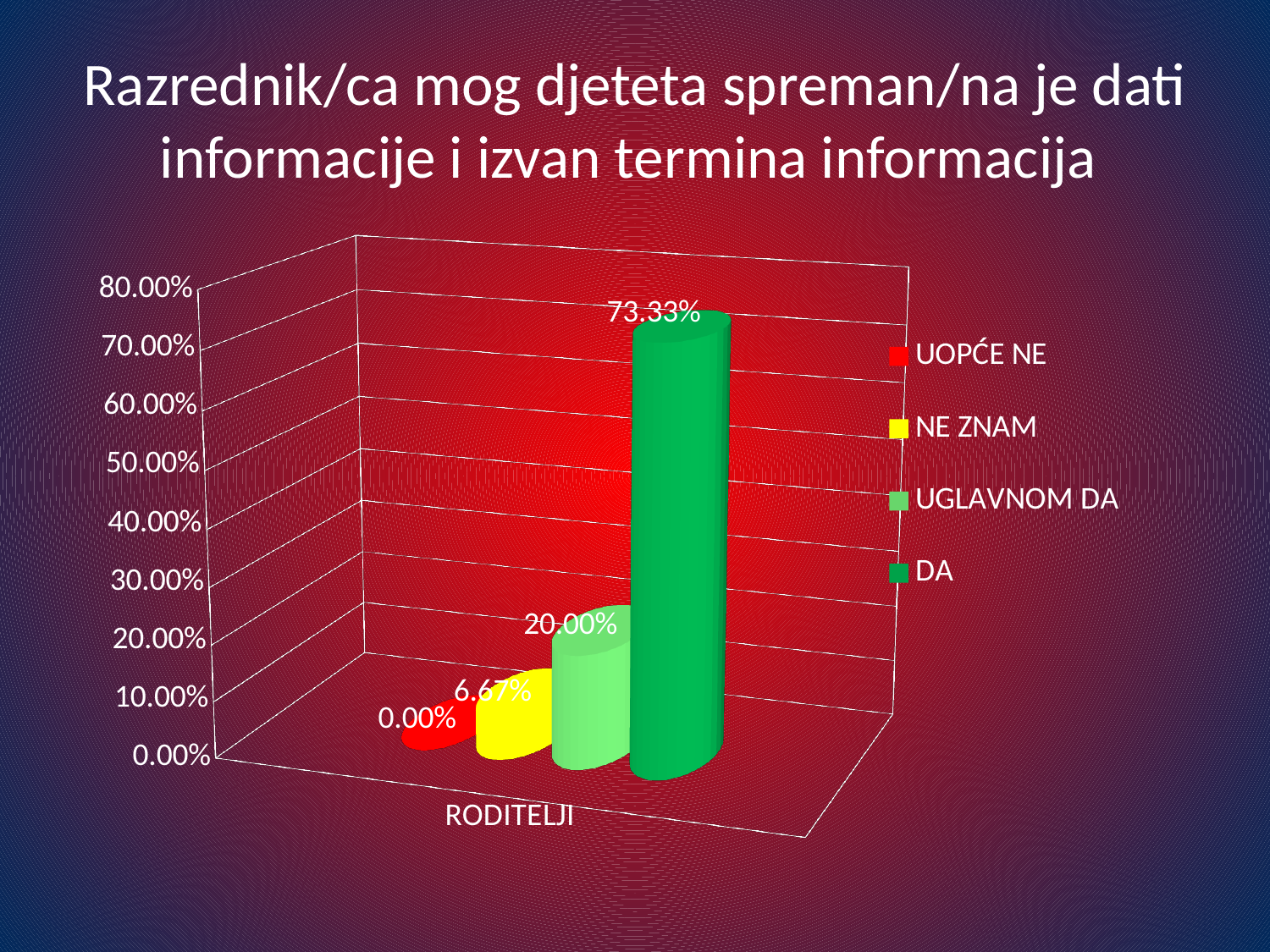
What is the value for DA? 73.33% What is the value for UOPĆE NE? 0.00% How many series does the legend list? 4 Which is larger, the value for UGLAVNOM DA or the value for NE ZNAM? UGLAVNOM DA What is the category label on the x axis? RODITELJI What is the difference between the values for DA and UGLAVNOM DA? 53.33% Which series has the highest value? DA What is the value for NE ZNAM? 6.67% Which series has the lowest value? UOPĆE NE Is the value for DA greater or less than 70.00%? greater What kind of chart is shown on the slide? bar chart What is the value for UGLAVNOM DA? 20.00%